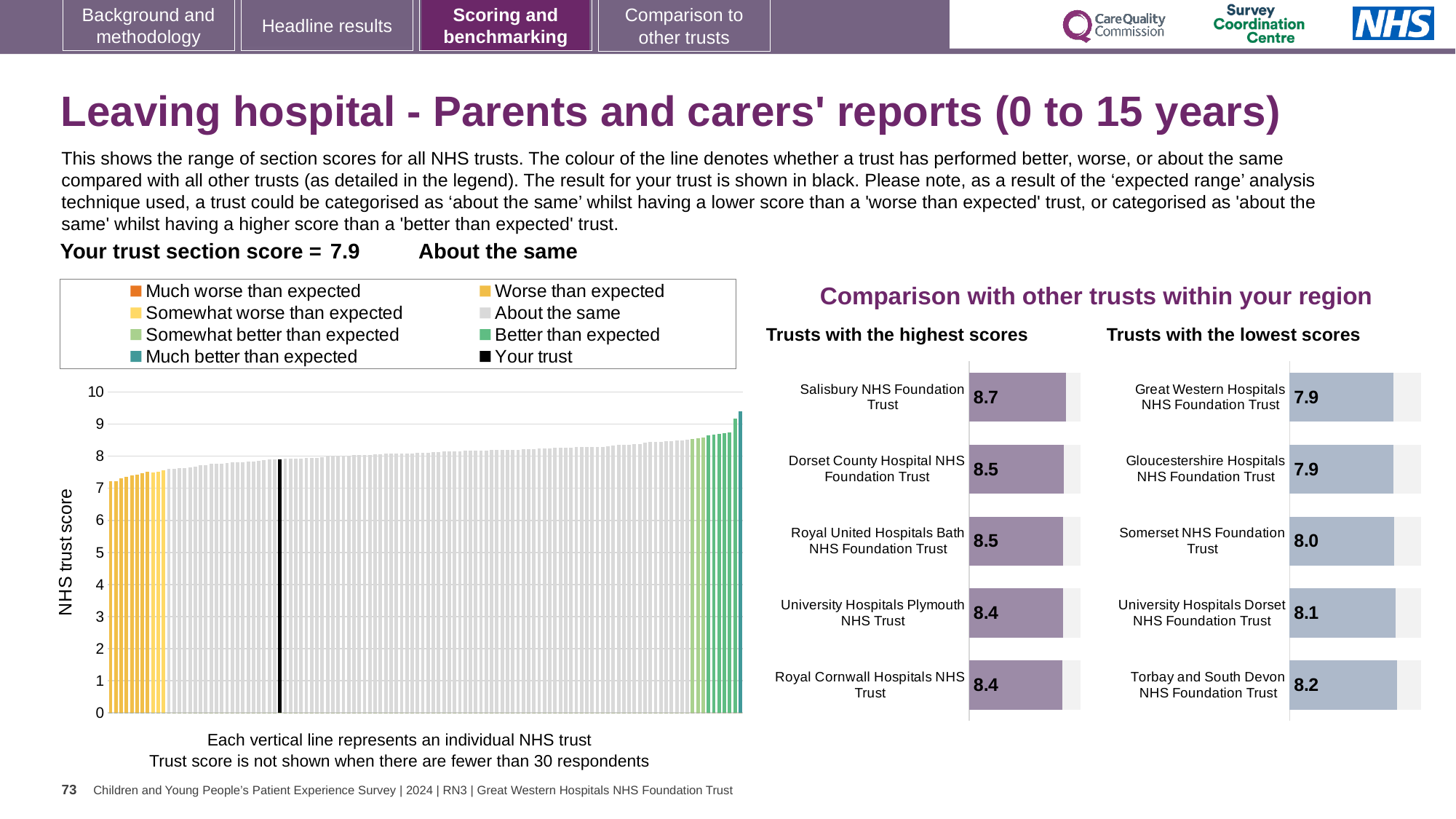
In the 'Trusts with the highest scores' chart, what is the score for Salisbury NHS Foundation Trust? 8.7 In the 'Trusts with the highest scores' chart, which trust has the highest score? Salisbury NHS Foundation Trust In the large chart on the left showing all NHS trusts, what kind of chart is it? Bar chart In the large chart on the left showing all NHS trusts, how many entries does the legend list? 8 In the 'Trusts with the lowest scores' chart, which is larger: the score for Torbay and South Devon NHS Foundation Trust or the score for Great Western Hospitals NHS Foundation Trust? Torbay and South Devon NHS Foundation Trust In the 'Trusts with the lowest scores' chart, which trust has the highest score? Torbay and South Devon NHS Foundation Trust In the 'Trusts with the highest scores' chart, what is the difference between the scores of Salisbury NHS Foundation Trust and University Hospitals Plymouth NHS Trust? 0.3 In the 'Trusts with the highest scores' chart, how many trusts are shown? 5 In the large chart on the left showing all NHS trusts, do the values rise or fall from left to right? Rise In the 'Trusts with the lowest scores' chart, what is the score for Somerset NHS Foundation Trust? 8.0 In the 'Trusts with the lowest scores' chart, what is the difference between the scores of Torbay and South Devon NHS Foundation Trust and Somerset NHS Foundation Trust? 0.2 In the large chart on the left showing all NHS trusts, is the value of the tallest bar greater or less than 9? greater